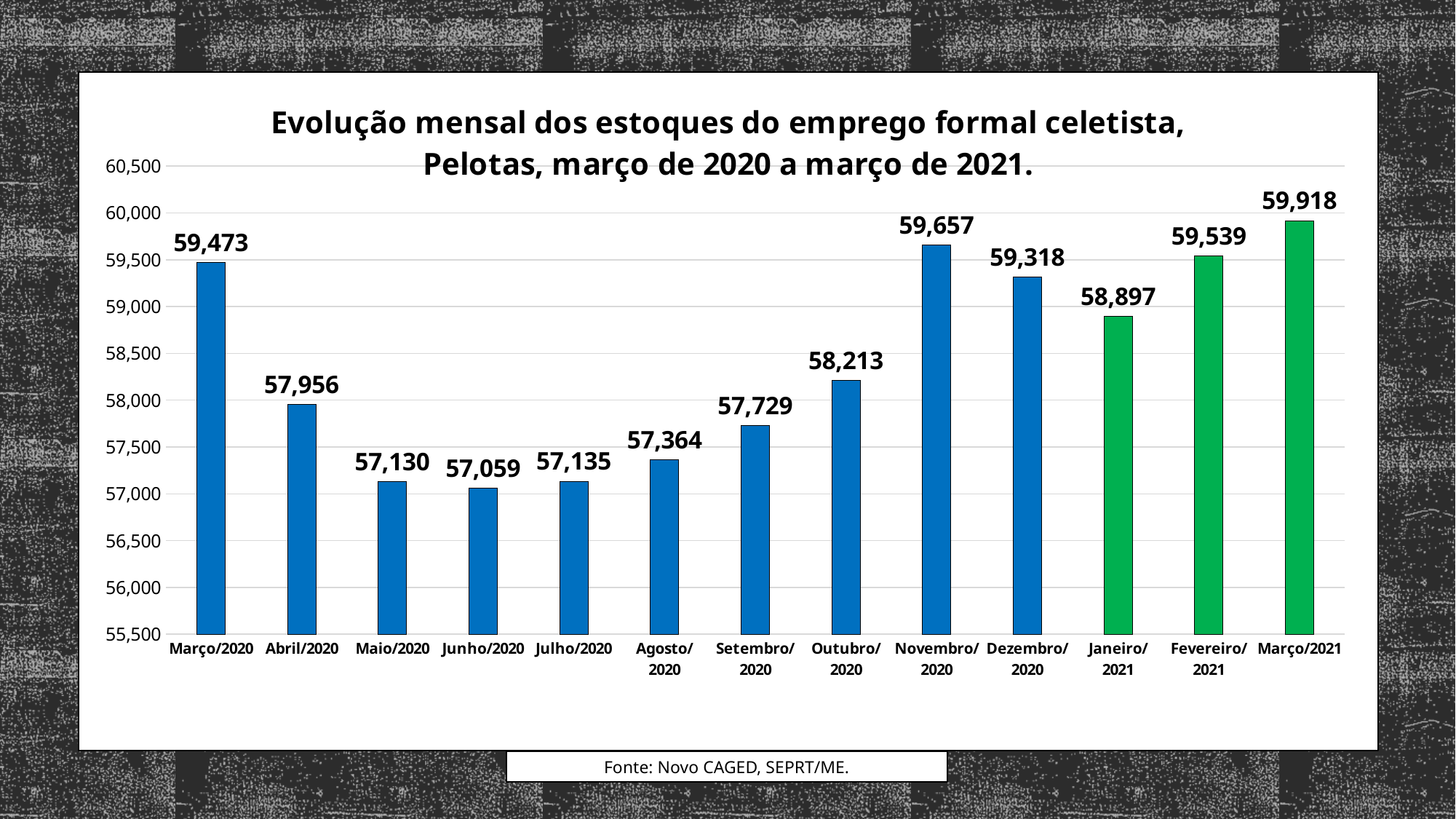
Do the values rise or fall from Junho/2020 to Novembro/2020? rise What is the value for Outubro/2020? 58,213 Which month has the lowest value? Junho/2020 Which month has the highest value? Março/2021 What is the difference between the values for Março/2021 and Março/2020? 445 Is the value for Setembro/2020 greater or less than 58,000? less What is the value for Março/2020? 59,473 Which is larger, the value for Novembro/2020 or the value for Fevereiro/2021? Novembro/2020 What is the difference between the values for Novembro/2020 and Dezembro/2020? 339 How many months are shown on the x axis? 13 What is the value for Janeiro/2021? 58,897 What kind of chart is shown on the slide? bar chart